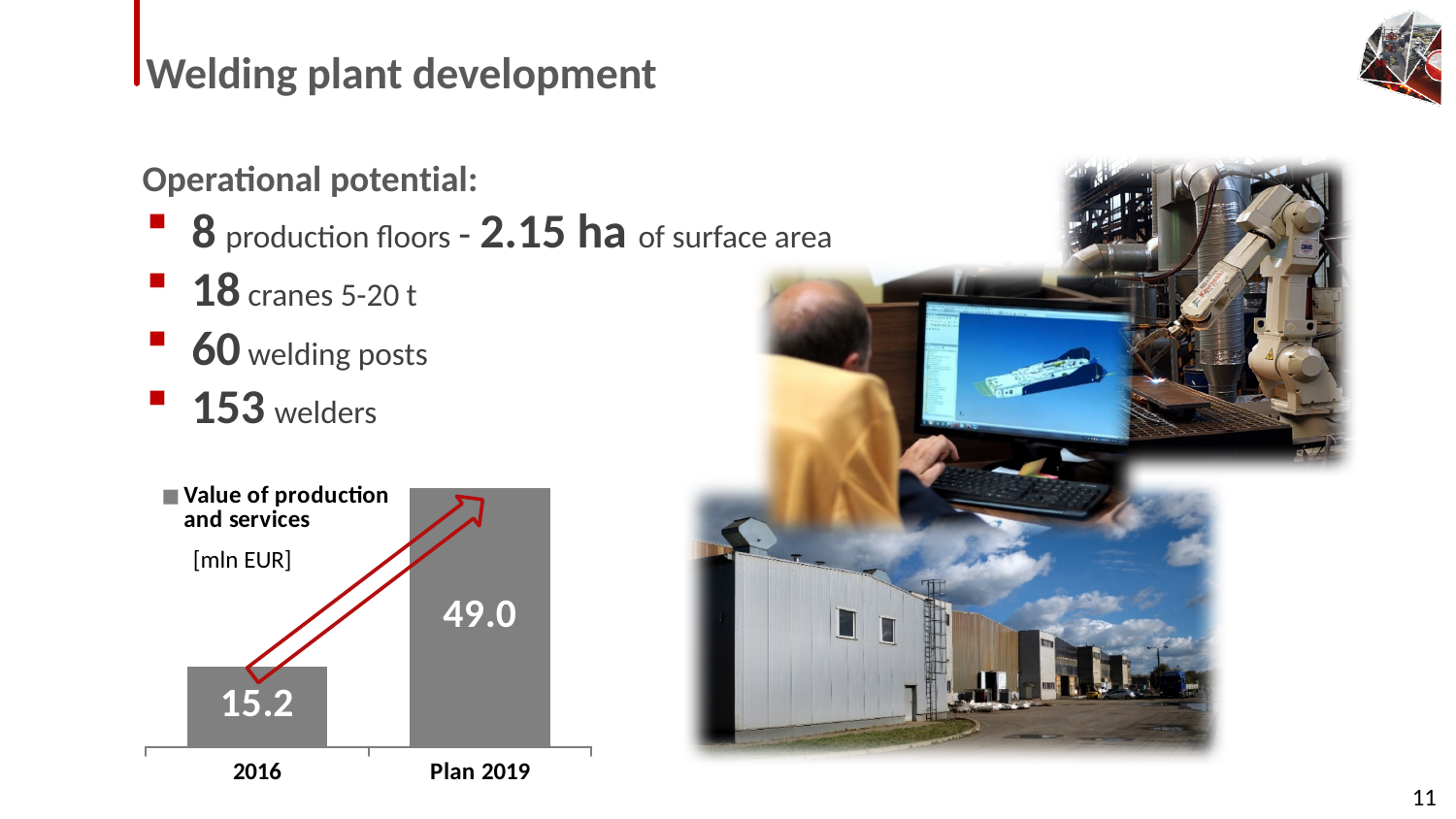
How many series does the chart legend list? 1 What is the name of the series in the chart legend? Value of production and services What unit is given for the chart values? mln EUR What is the value of production and services for 2016? 15.2 Do the values rise or fall from 2016 to Plan 2019? rise Which category has the higher value of production and services? Plan 2019 What is the difference between the Plan 2019 value and the 2016 value? 33.8 What kind of chart is shown on the slide? bar chart How many categories are shown on the x axis of the chart? 2 Is the value for 2016 larger or smaller than the value for Plan 2019? smaller What is the value of production and services for Plan 2019? 49.0 Which category has the lower value of production and services? 2016